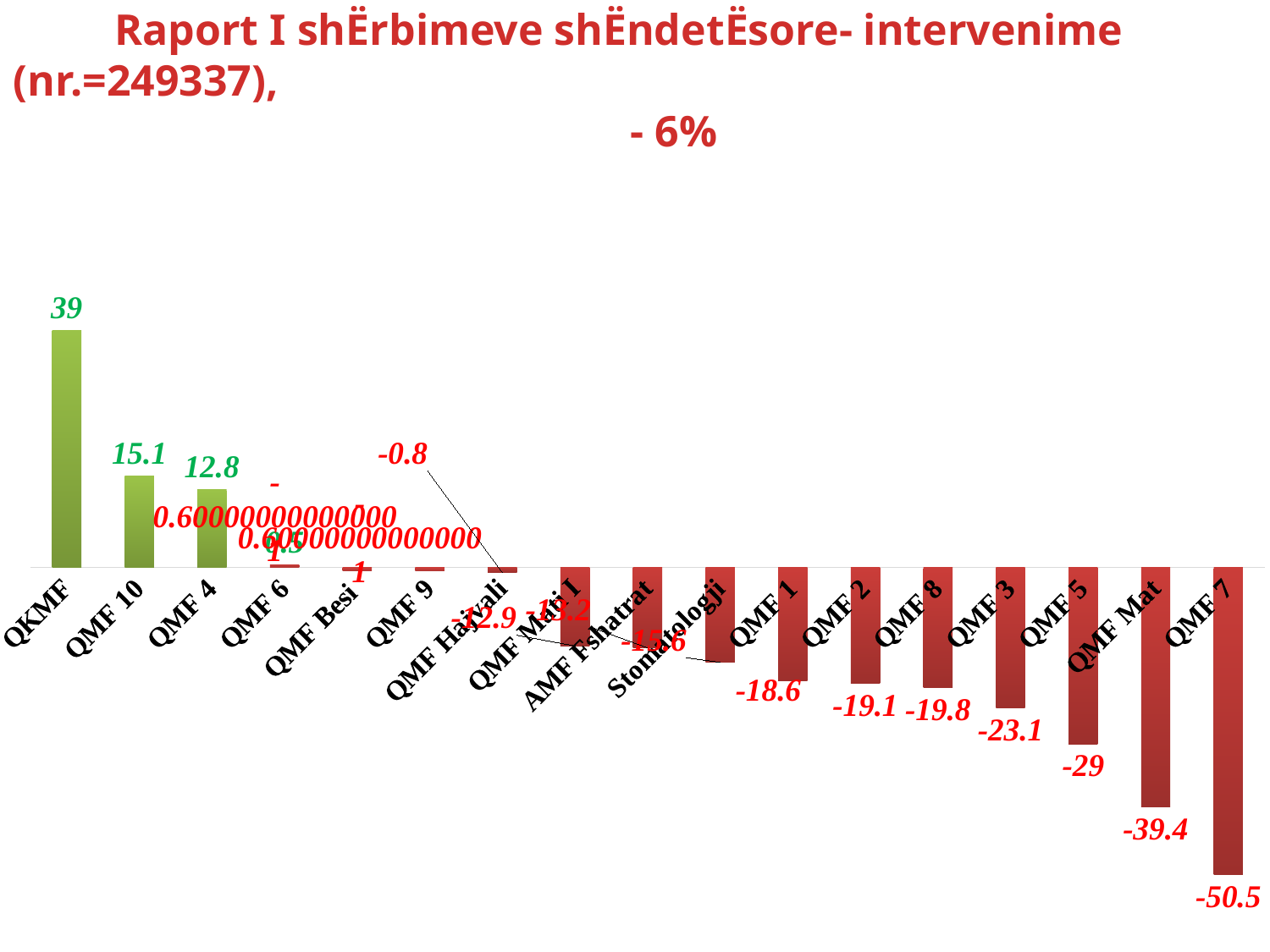
Do the values rise or fall from left to right along the x axis? Fall Which category has the highest value? QKMF What is the value for QKMF? 39 What is the difference between the values for QKMF and QMF 10? 23.9 What kind of chart is shown on the slide? Bar chart What is the value for QMF 7? -50.5 What is the value for QMF 1? -18.6 How many categories are shown on the x axis? 17 Which category has the lowest value? QMF 7 What is the value for QMF 10? 15.1 What is the value for QMF 5? -29 Which has the larger value, QMF 3 or QMF 5? QMF 3